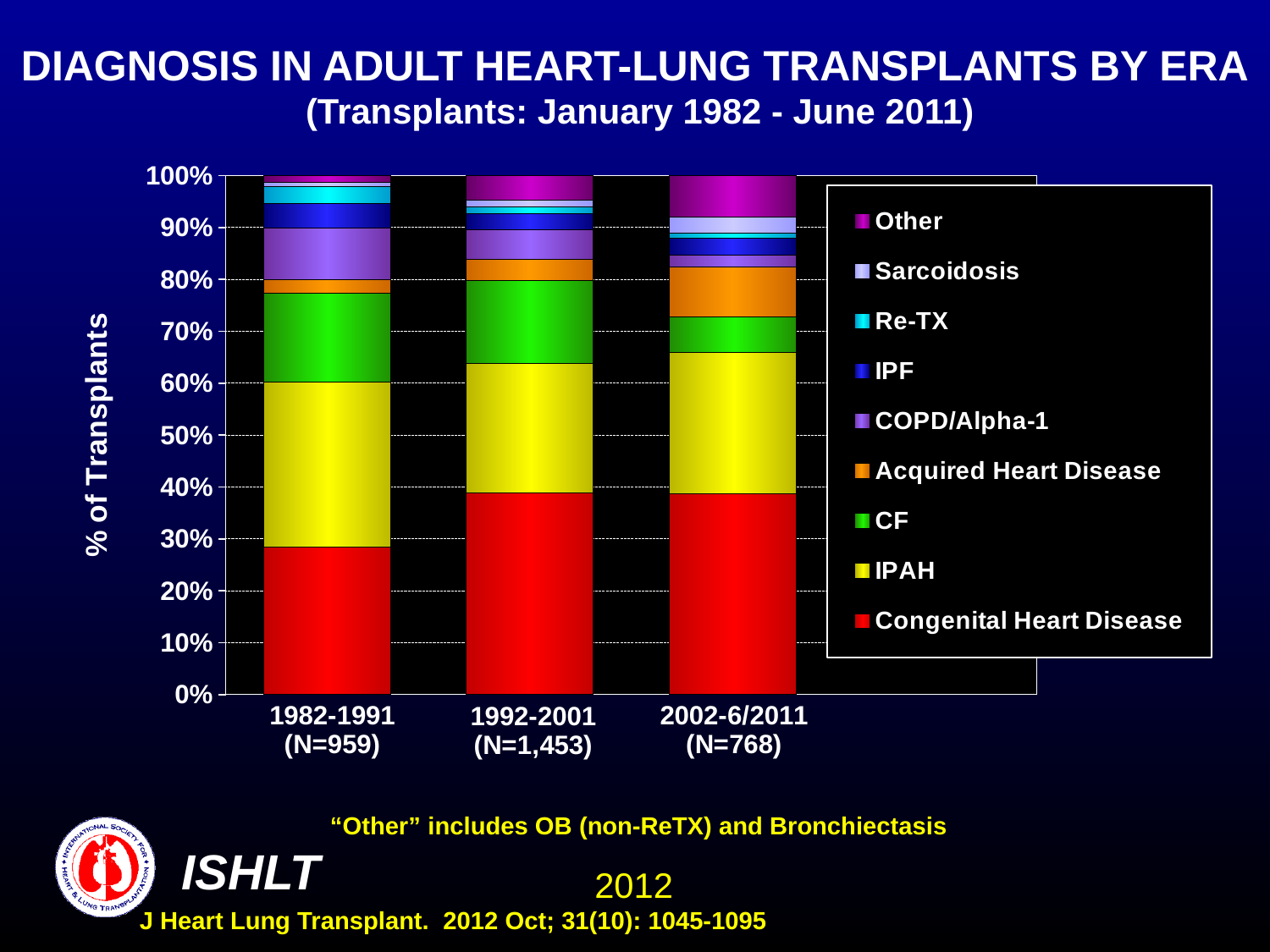
Which era has the largest Acquired Heart Disease segment? 2002-6/2011 Which era has the larger CF share, 1982-1991 or 2002-6/2011? 1982-1991 Which diagnosis is the largest segment in the 1992-2001 bar? Congenital Heart Disease What kind of chart is shown on the slide? Stacked bar chart How many era categories are shown on the x axis? 3 How many diagnosis series does the legend list? 9 Is the Congenital Heart Disease share for 1982-1991 greater or less than 40%? less What is the number of transplants (N) shown for the 1992-2001 era? N=1,453 What is the label of the y axis? % of Transplants Is the Congenital Heart Disease share for 2002-6/2011 greater or less than 30%? greater Which era has the largest Other segment? 2002-6/2011 Which era has the larger Congenital Heart Disease share, 1982-1991 or 1992-2001? 1992-2001